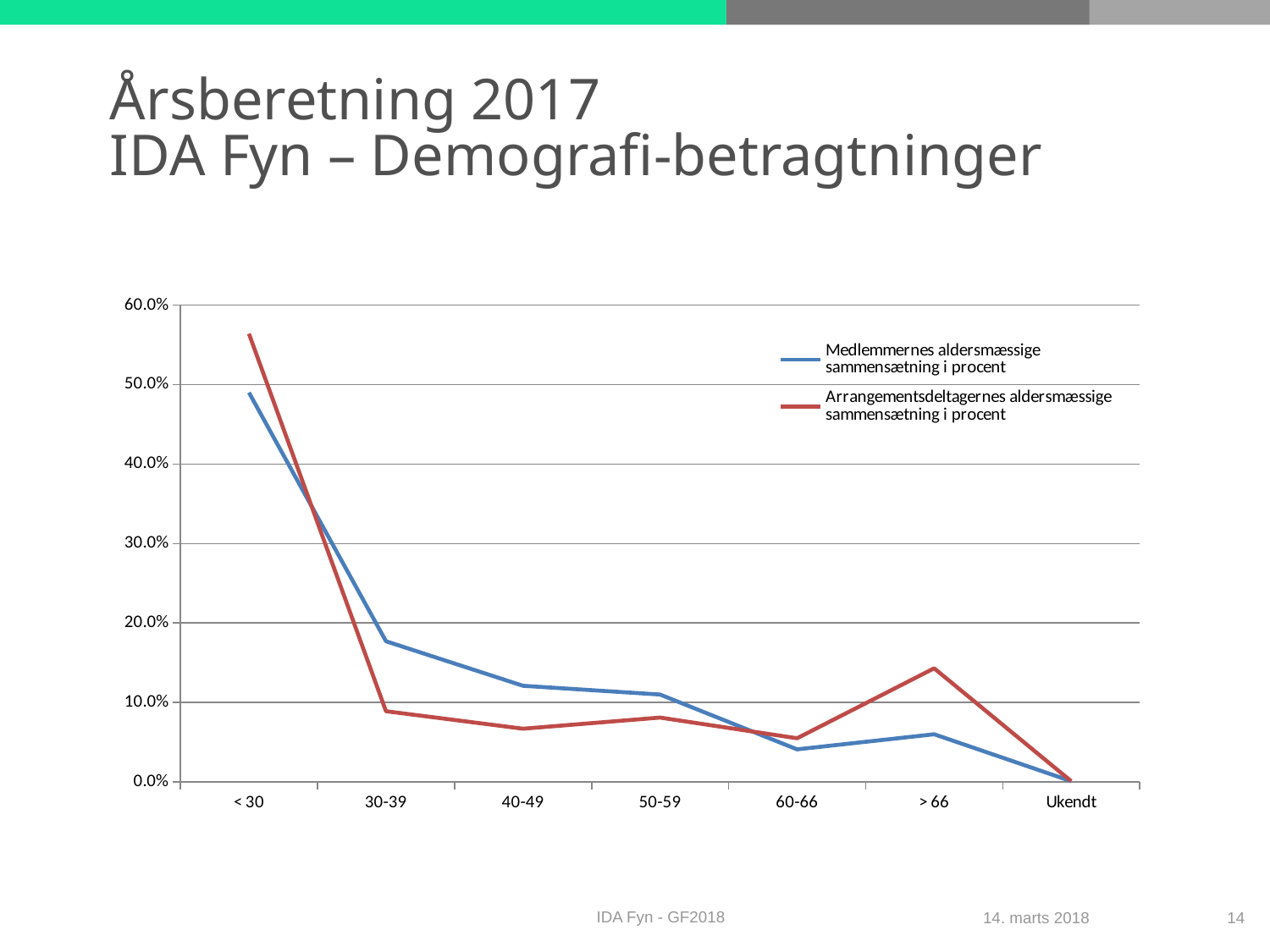
Does the 'Medlemmernes aldersmæssige sammensætning i procent' line rise or fall from '< 30' to '60-66'? fall What kind of chart is shown on the slide? line chart Is the value for 'Arrangementsdeltagernes aldersmæssige sammensætning i procent' at '< 30' greater or less than 50.0%? greater Which age category has the highest value for 'Arrangementsdeltagernes aldersmæssige sammensætning i procent'? < 30 Is the value for 'Arrangementsdeltagernes aldersmæssige sammensætning i procent' at '> 66' greater or less than 10.0%? greater How many age categories are shown on the x axis? 7 What colour is the line for 'Arrangementsdeltagernes aldersmæssige sammensætning i procent'? red Is the value for 'Medlemmernes aldersmæssige sammensætning i procent' at '30-39' greater or less than 20.0%? less Which age category has the highest value for 'Medlemmernes aldersmæssige sammensætning i procent'? < 30 At '30-39', which series has the larger value: 'Medlemmernes aldersmæssige sammensætning i procent' or 'Arrangementsdeltagernes aldersmæssige sammensætning i procent'? Medlemmernes aldersmæssige sammensætning i procent How many series does the legend list? 2 At '> 66', which series has the larger value: 'Medlemmernes aldersmæssige sammensætning i procent' or 'Arrangementsdeltagernes aldersmæssige sammensætning i procent'? Arrangementsdeltagernes aldersmæssige sammensætning i procent